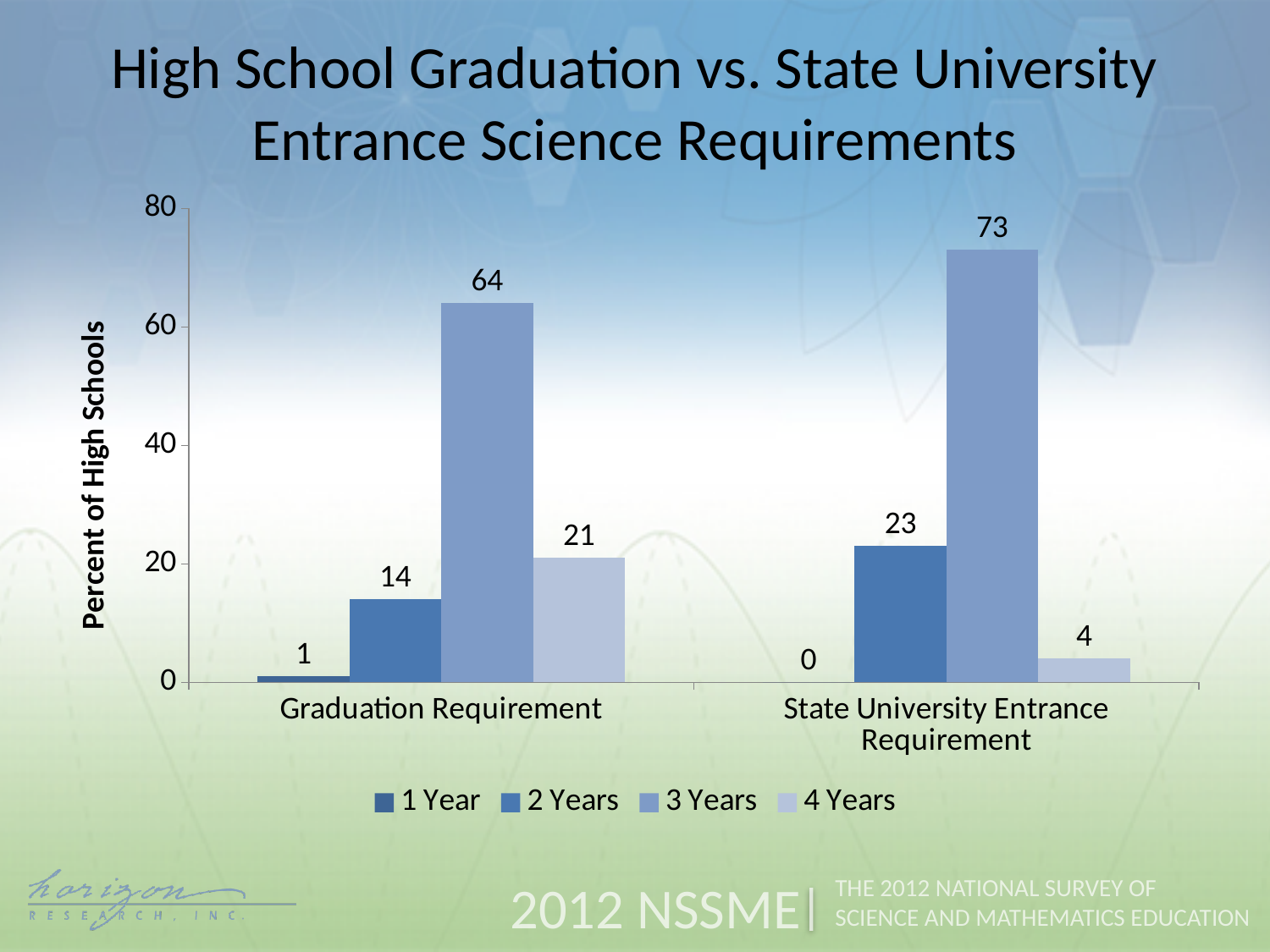
Which series has the highest value under State University Entrance Requirement? 3 Years How many categories are shown on the x axis? 2 What is the difference between the 3 Years values for State University Entrance Requirement and Graduation Requirement? 9 What is the value for 4 Years under State University Entrance Requirement? 4 Which is larger: the 4 Years value for Graduation Requirement or the 4 Years value for State University Entrance Requirement? Graduation Requirement What is the value for 1 Year under Graduation Requirement? 1 What kind of chart is shown on the slide? Bar chart What percent of high schools have a 3 Years science graduation requirement? 64 How many series does the legend list? 4 What is the value for 2 Years under State University Entrance Requirement? 23 What is the label of the y axis? Percent of High Schools Which series has the lowest value under Graduation Requirement? 1 Year